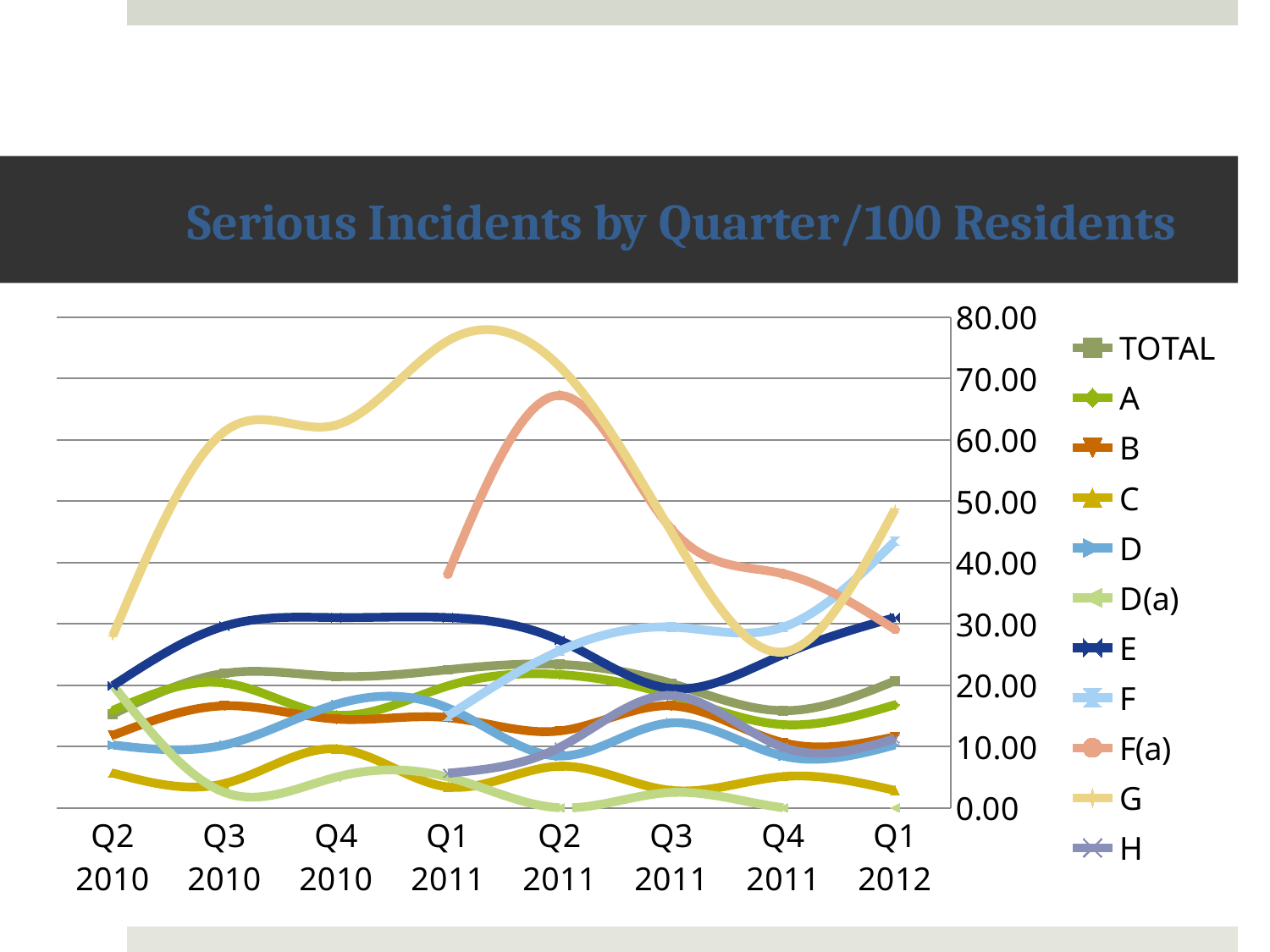
Does the value for F(a) rise or fall from Q2 2011 to Q1 2012? fall In which quarter does series G reach its peak? Q1 2011 Is the value for F(a) in Q2 2011 greater or less than 60? greater In Q1 2012, which is higher, G or E? G Which series reaches the highest value anywhere on the chart? G What kind of chart is shown on the slide? line chart How many quarters are shown along the x axis? 8 Is the value for D(a) in Q2 2011 greater or less than 10? less Is the value for G in Q1 2011 greater or less than 70? greater How many series does the legend list? 11 Which series has the lowest value in Q2 2011? D(a) What is the title of the chart? Serious Incidents by Quarter/100 Residents